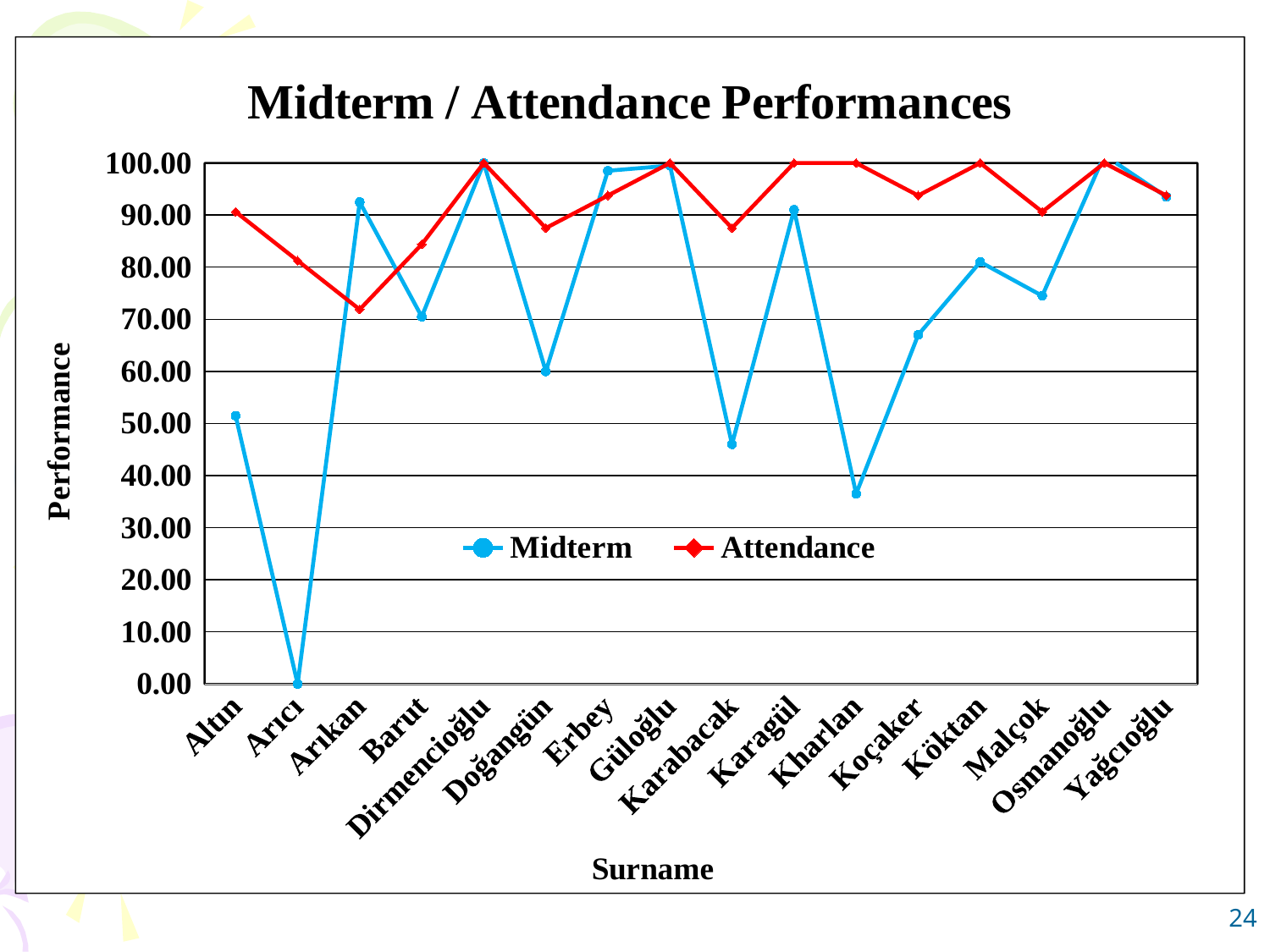
What is the Midterm value for Arıcı? 0.00 What is the Attendance value for Karagül? 100.00 How many series does the legend list? 2 For Kharlan, which is larger, the Midterm value or the Attendance value? Attendance Is the Midterm value for Arıkan greater or less than 90.00? greater Is the Midterm value for Malçok greater or less than 80.00? less What kind of chart is shown on the slide? line chart Is the Midterm value for Kharlan greater or less than 40.00? less How many surnames are plotted along the x axis? 16 Which surname has the lowest Attendance value? Arıkan What is the title of the chart? Midterm / Attendance Performances Which surname has the lowest Midterm value? Arıcı